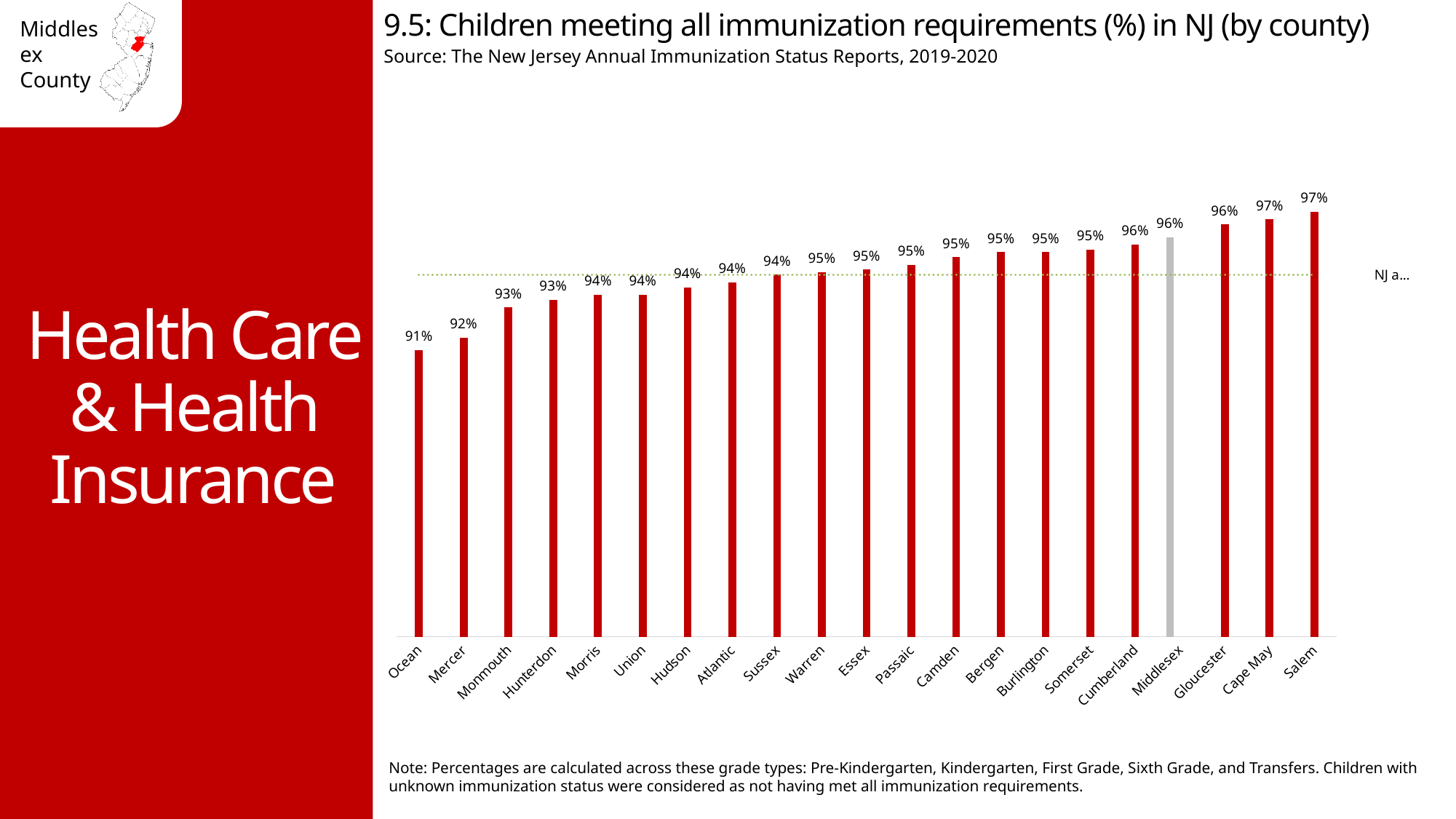
What is the difference in percentage points between Salem and Ocean? 6 percentage points What is the value shown for Cape May? 97% Do the values rise or fall moving from left to right across the counties? Rise What is the difference in percentage points between Middlesex and Mercer? 4 percentage points Which has a higher value, Middlesex or Monmouth? Middlesex What percentage is shown for Hunterdon County? 93% What is the value shown for Ocean County? 91% Which county has the lowest percentage of children meeting all immunization requirements? Ocean What percentage of children in Middlesex County met all immunization requirements? 96% How many counties are shown on the chart? 21 What type of chart is used on this slide? Bar chart Which county's bar is coloured grey instead of red? Middlesex